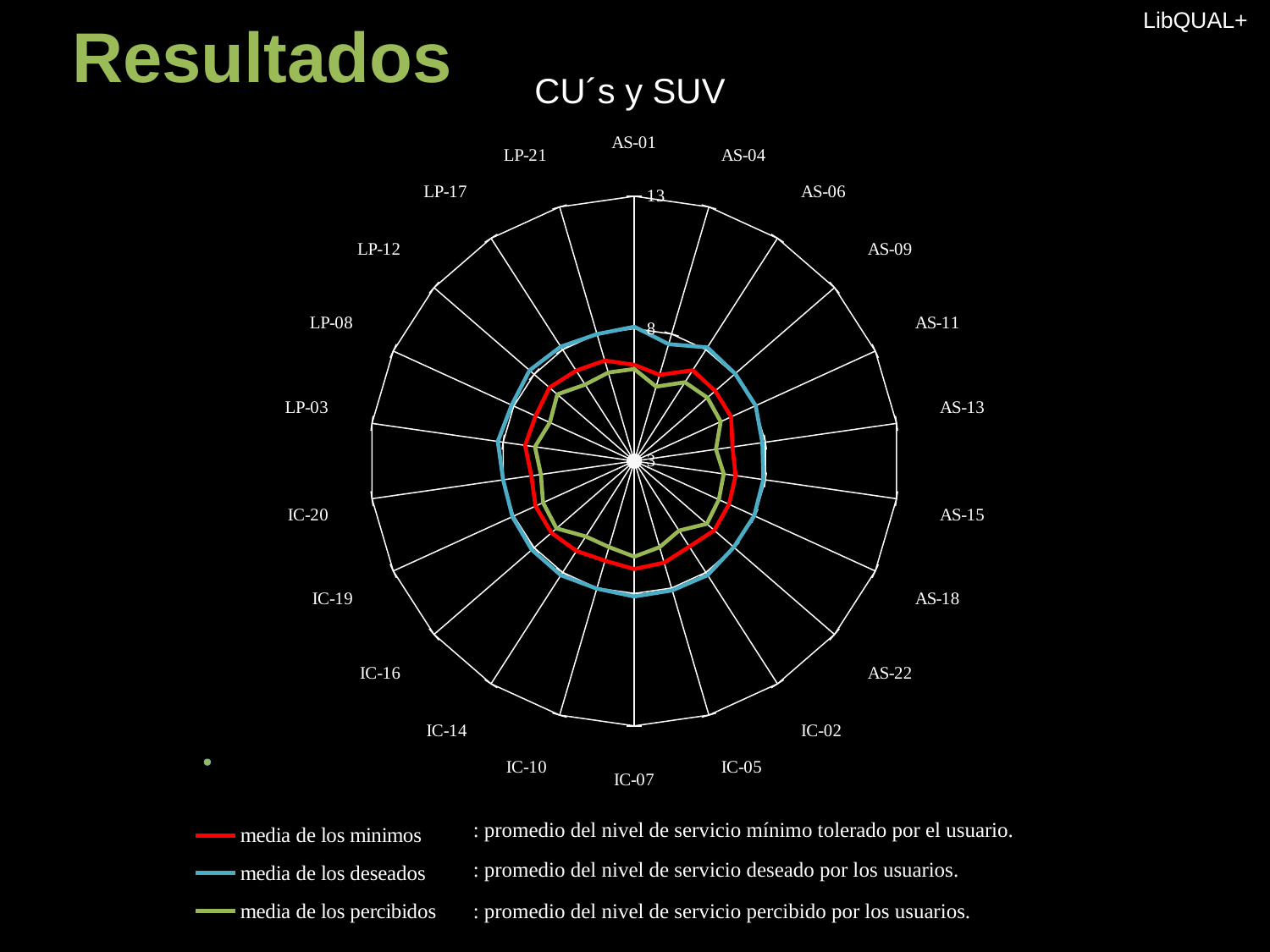
Which colour represents the series 'media de los minimos'? red Is the value of media de los percibidos at IC-07 greater or less than 8? less Is the value of media de los percibidos at AS-01 greater or less than 8? less How many categories are plotted around the radar chart? 22 What kind of chart is shown on the slide? radar chart How many series does the legend of the chart list? 3 Is the value of media de los minimos at IC-07 greater or less than 3? greater At IC-07, which series has the larger value: media de los minimos or media de los percibidos? media de los minimos At LP-03, which series has the larger value: media de los deseados or media de los minimos? media de los deseados What is the title of the radar chart? CU´s y SUV At AS-01, which series has the larger value: media de los deseados or media de los percibidos? media de los deseados